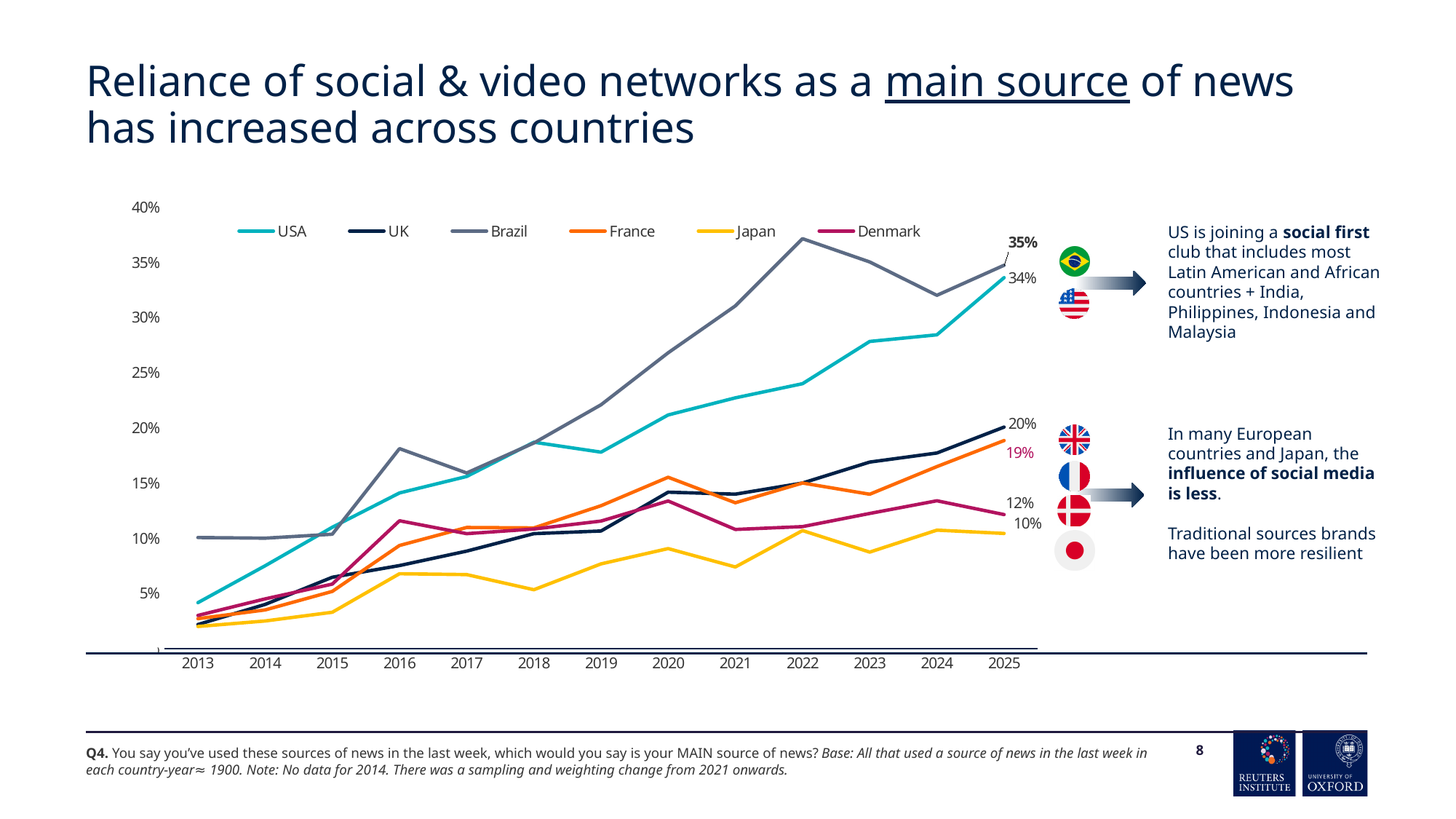
Which country has the lowest value in 2025? Japan Does the USA line generally rise or fall from 2013 to 2025? rise What is the value for Brazil in 2025? 35% How many years are labelled on the x axis? 13 What is the value for Japan in 2025? 10% How many series does the chart legend list? 6 What kind of chart is shown on the slide? line chart What is the value for the USA in 2025? 34% What is the difference between the UK and Denmark values in 2025? 8% Is the value for Brazil in 2022 greater or less than 35%? greater What is the value for the UK in 2025? 20% Which is larger in 2025, the value for France or the value for Denmark? France